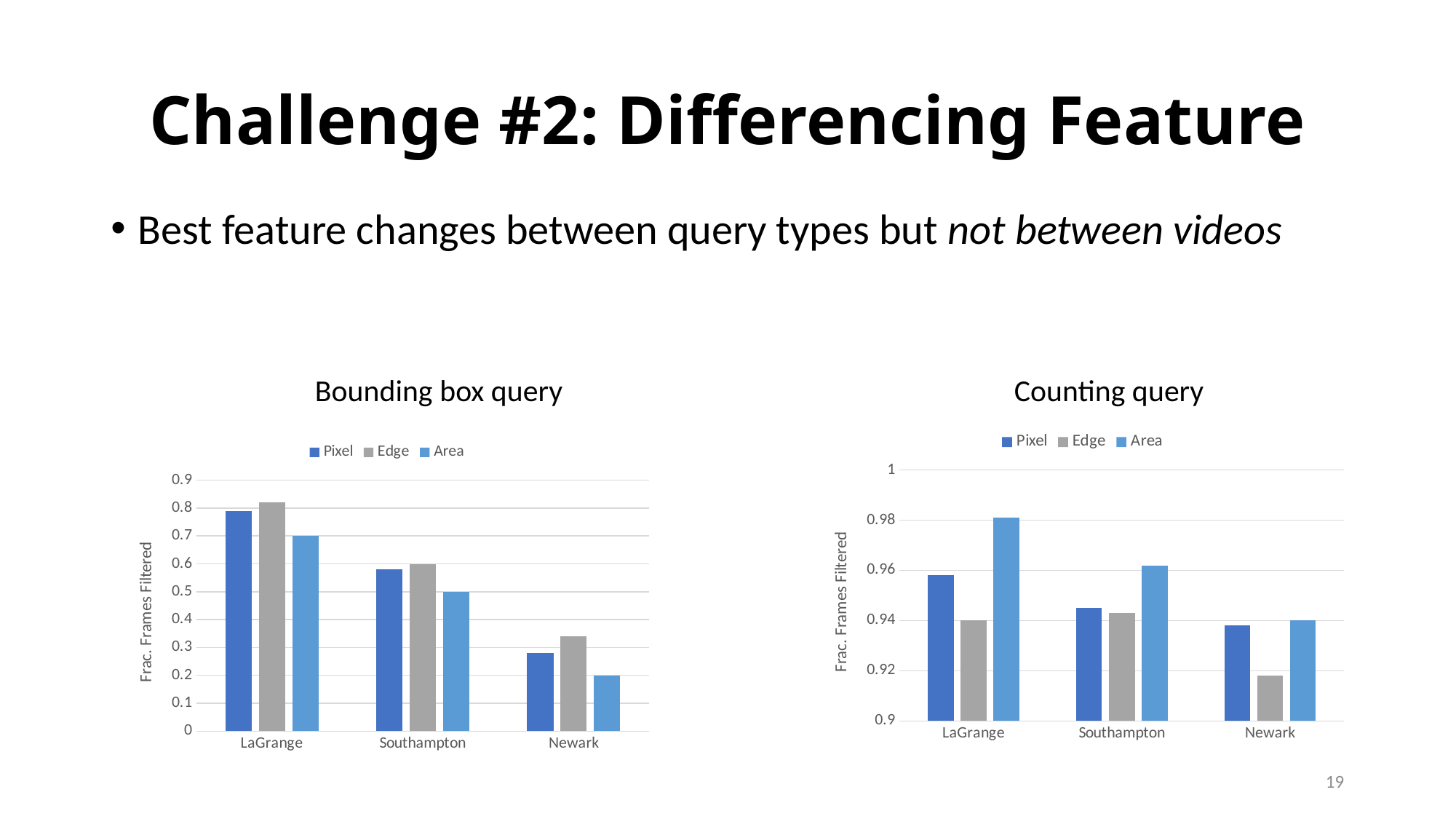
What is the y-axis label of the Counting query chart? Frac. Frames Filtered In the Bounding box query chart, do the Pixel values rise or fall from LaGrange to Newark? fall How many series does the legend of the Counting query chart list? 3 In the Counting query chart, which series has the lowest value for Newark? Edge In the Bounding box query chart, which series has the lowest value for Newark? Area In the Bounding box query chart, which series has the highest value for LaGrange? Edge In the Bounding box query chart, which is larger for Newark: the Pixel value or the Edge value? Edge How many video categories are shown on the x axis of the Bounding box query chart? 3 What kind of chart is the Bounding box query chart? bar chart In the Bounding box query chart, is the Pixel value for Southampton greater or less than 0.5? greater In the Counting query chart, which series has the highest value for LaGrange? Area